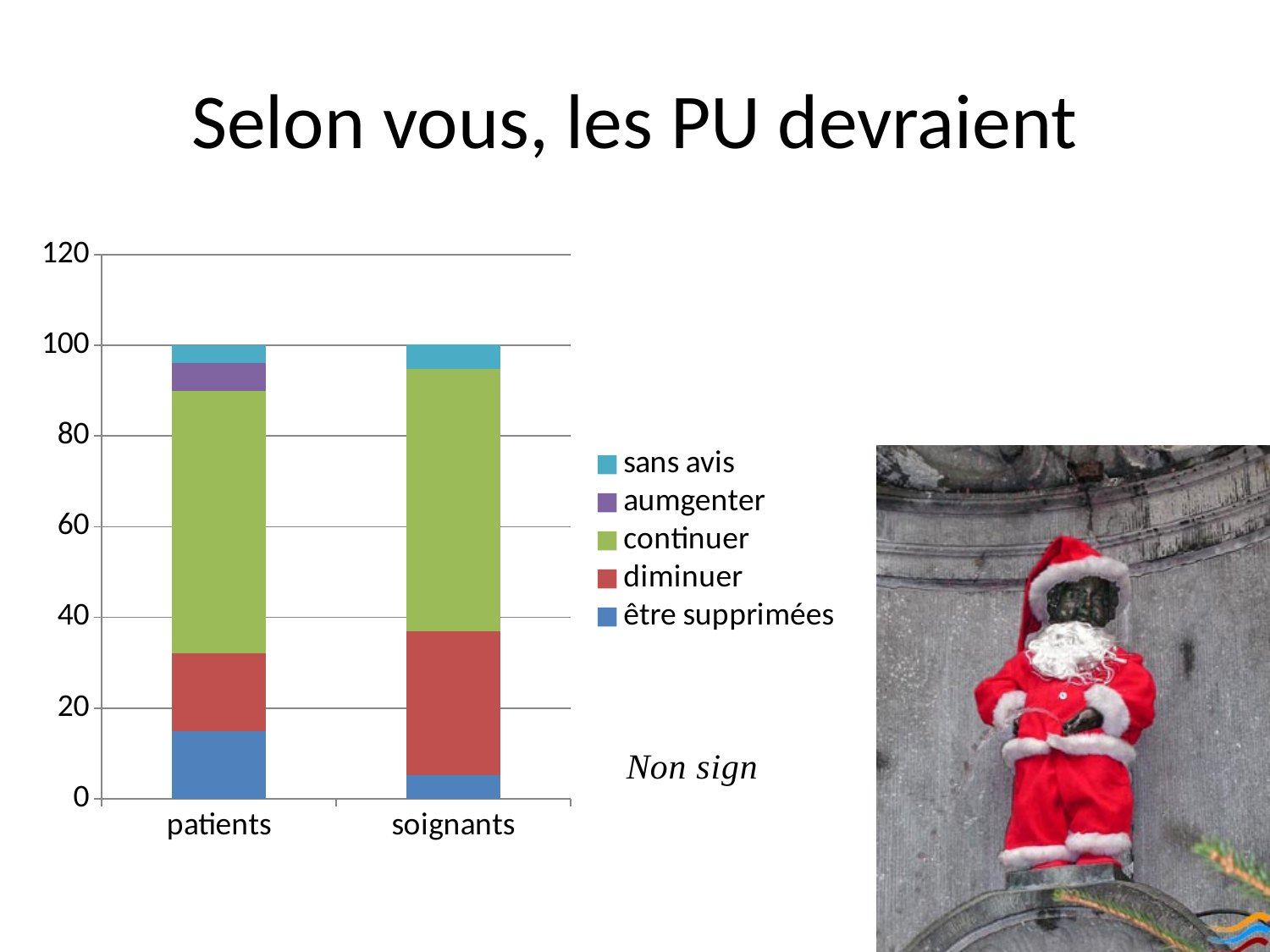
What is the total height of the stacked bar for patients? 100 Is the 'diminuer' segment for soignants greater or less than 20? greater How many categories are shown on the x axis of the chart? 2 Which category has the larger 'être supprimées' segment, patients or soignants? patients What is the total height of the stacked bar for soignants? 100 Is the 'continuer' segment for patients greater or less than 40? greater What is the title of the slide containing the chart? Selon vous, les PU devraient Is the 'être supprimées' segment for patients greater or less than 20? less Which category's bar includes an 'aumgenter' segment? patients What kind of chart is shown on the slide? stacked bar chart How many series does the chart's legend list? 5 Which category has the larger 'diminuer' segment, patients or soignants? soignants